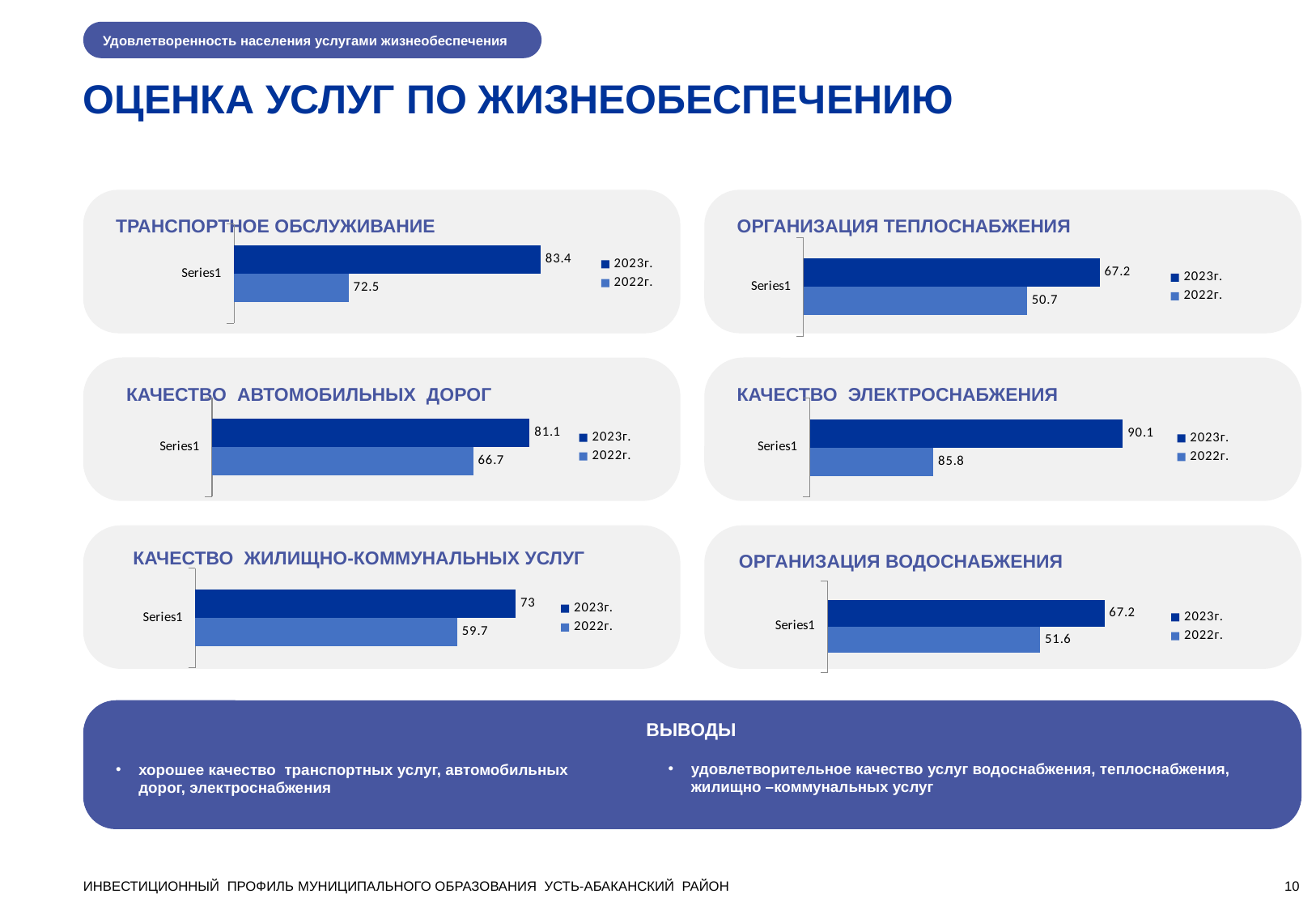
In the 'КАЧЕСТВО ЖИЛИЩНО-КОММУНАЛЬНЫХ УСЛУГ' chart, what is the difference between the 2023г. and 2022г. values? 13.3 What kind of chart is the 'ТРАНСПОРТНОЕ ОБСЛУЖИВАНИЕ' chart? Bar chart In the 'ТРАНСПОРТНОЕ ОБСЛУЖИВАНИЕ' chart, what is the value for 2023г.? 83.4 In the 'ОРГАНИЗАЦИЯ ТЕПЛОСНАБЖЕНИЯ' chart, what is the value for 2022г.? 50.7 In the 'ОРГАНИЗАЦИЯ ВОДОСНАБЖЕНИЯ' chart, what is the value for 2022г.? 51.6 In the 'КАЧЕСТВО ЖИЛИЩНО-КОММУНАЛЬНЫХ УСЛУГ' chart, what is the value for 2023г.? 73 In the 'КАЧЕСТВО АВТОМОБИЛЬНЫХ ДОРОГ' chart, what is the value for 2023г.? 81.1 In the 'КАЧЕСТВО ЭЛЕКТРОСНАБЖЕНИЯ' chart, what is the value for 2022г.? 85.8 In the 'КАЧЕСТВО ЭЛЕКТРОСНАБЖЕНИЯ' chart, which series has the higher value, 2023г. or 2022г.? 2023г. How many series does the legend of the 'ОРГАНИЗАЦИЯ ВОДОСНАБЖЕНИЯ' chart list? 2 In the 'ОРГАНИЗАЦИЯ ТЕПЛОСНАБЖЕНИЯ' chart, what is the difference between the 2023г. and 2022г. values? 16.5 In the 'ТРАНСПОРТНОЕ ОБСЛУЖИВАНИЕ' chart, what is the value for 2022г.? 72.5